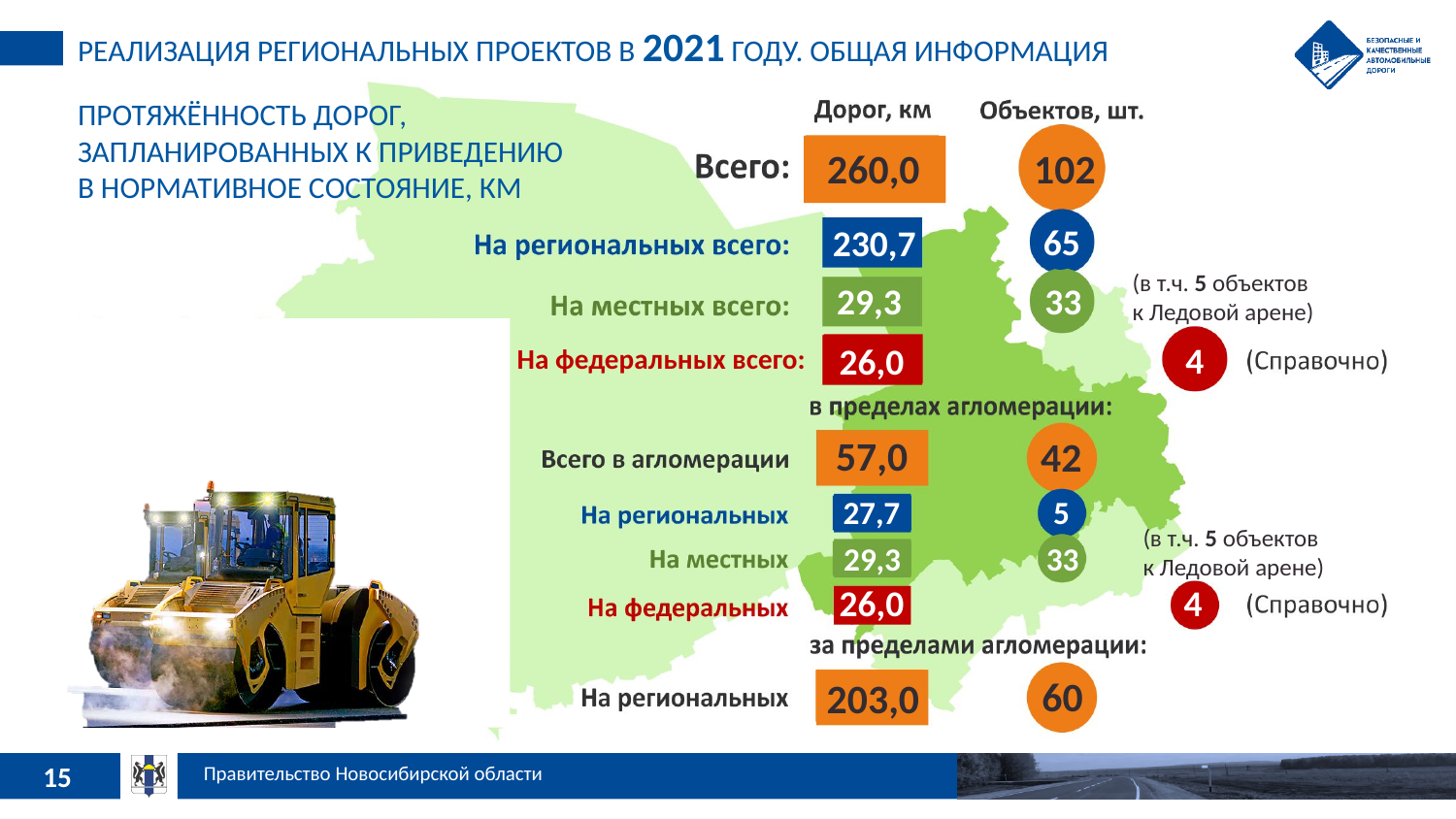
How many objects (Объектов, шт.) are shown for Всего? 102 Which has more objects: 'На региональных' within the agglomeration or 'На местных' within the agglomeration? На местных Which road category has the smallest length among 'На региональных всего', 'На местных всего' and 'На федеральных всего'? На федеральных всего What is the road length for 'Всего в агломерации'? 57,0 What is the difference between the total number of objects (Всего) and the number of objects for 'На региональных всего'? 37 What is the road length for 'На региональных всего'? 230,7 What is the difference in road length between 'На региональных всего' and 'На местных всего'? 201,4 Which road category has the greatest length among 'На региональных всего', 'На местных всего' and 'На федеральных всего'? На региональных всего How many objects are shown for 'На местных всего'? 33 How many objects are shown for 'На региональных' outside the agglomeration (за пределами агломерации)? 60 What is the total length of roads (Дорог, км) planned to be brought to normative condition (Всего)? 260,0 What is the road length for 'На федеральных всего'? 26,0